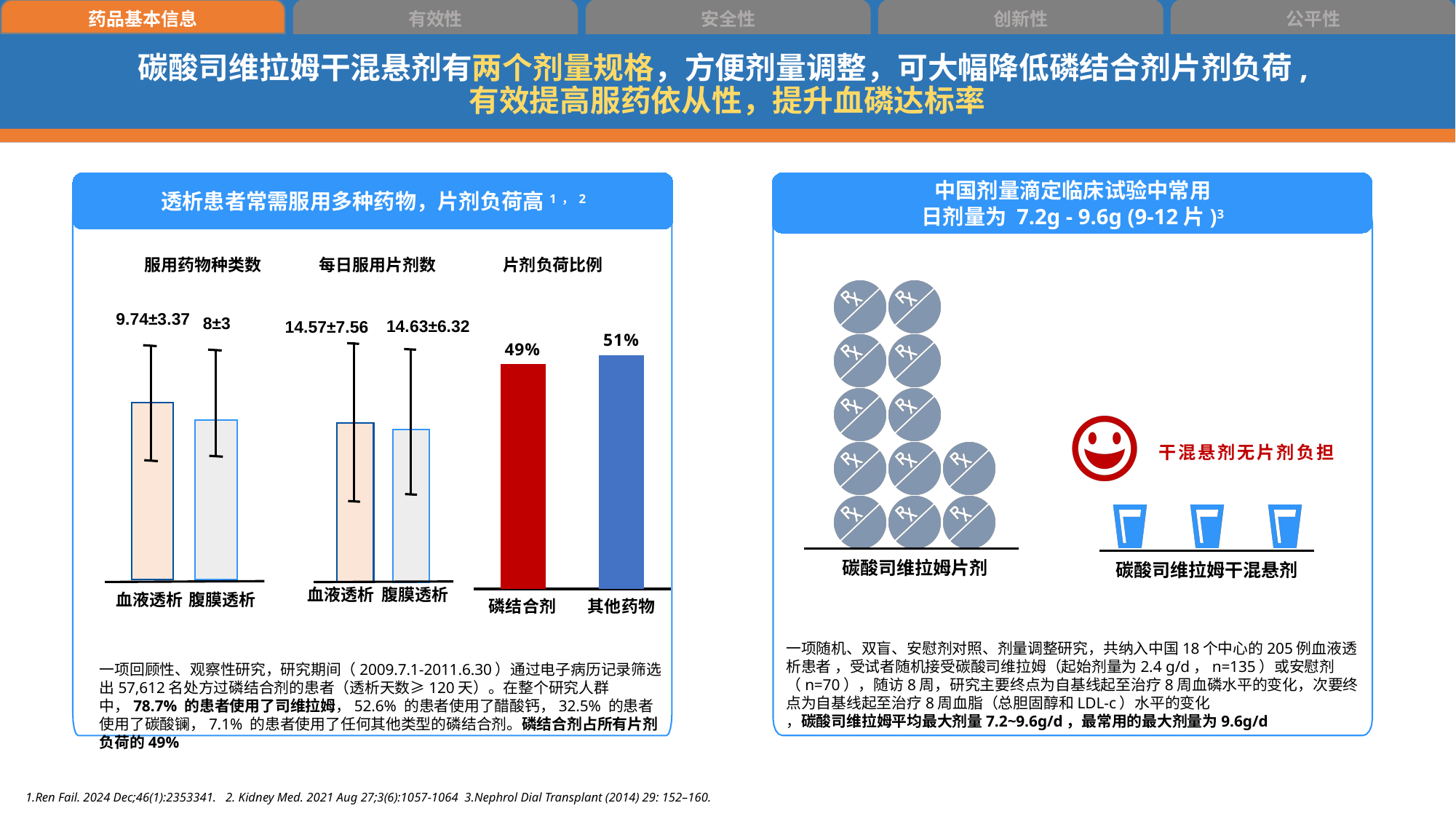
In the chart titled 每日服用片剂数, what is the value for 血液透析? 14.57±7.56 In the chart titled 服用药物种类数, what is the value for 血液透析? 9.74±3.37 How many categories are shown in the chart titled 片剂负荷比例? 2 What colour is the bar for 磷结合剂 in the chart titled 片剂负荷比例? Red In the chart titled 片剂负荷比例, what percentage is shown for 其他药物? 51% In the chart titled 片剂负荷比例, what is the difference between the values for 其他药物 and 磷结合剂? 2% In the chart titled 片剂负荷比例, what percentage is shown for 磷结合剂? 49% In the chart titled 片剂负荷比例, which category has the higher value? 其他药物 In the chart titled 每日服用片剂数, what is the value for 腹膜透析? 14.63±6.32 In the chart titled 服用药物种类数, what is the value for 腹膜透析? 8±3 What type of chart is used for 片剂负荷比例? Bar chart In the chart titled 服用药物种类数, which category has the higher mean value, 血液透析 or 腹膜透析? 血液透析